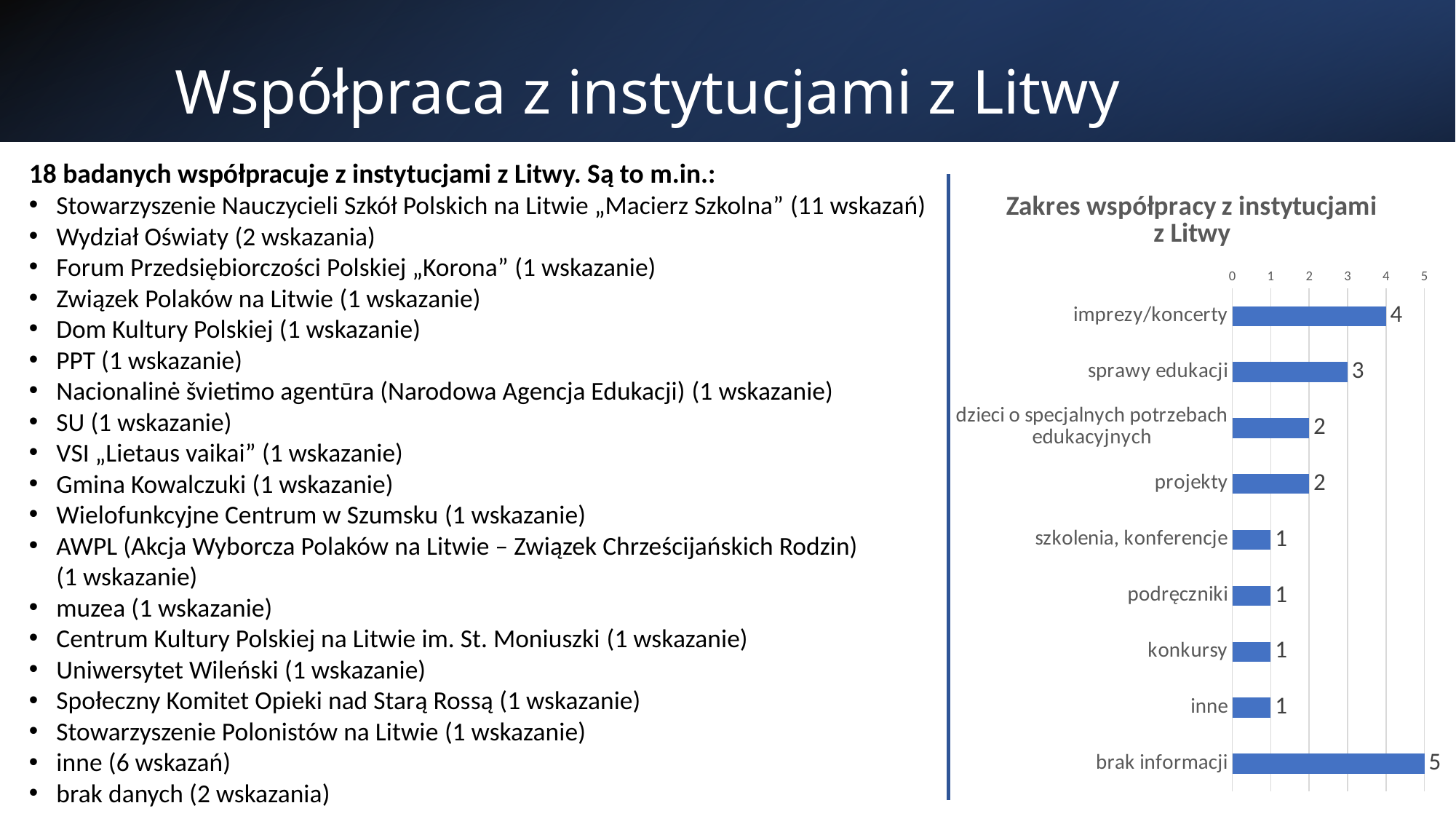
What is the value for 'projekty' in the chart? 2 What is the value for 'sprawy edukacji' in the chart? 3 Which is larger, the value for 'imprezy/koncerty' or the value for 'sprawy edukacji'? imprezy/koncerty How many categories are shown in the chart? 9 Which category has the highest value in the chart? brak informacji Which is larger, the value for 'projekty' or the value for 'konkursy'? projekty What is the difference between the values for 'brak informacji' and 'imprezy/koncerty'? 1 What is the title of the chart? Zakres współpracy z instytucjami z Litwy What is the value for 'brak informacji' in the chart? 5 What kind of chart is shown on the slide? bar chart What is the value for 'imprezy/koncerty' in the chart? 4 What is the difference between the values for 'sprawy edukacji' and 'podręczniki'? 2